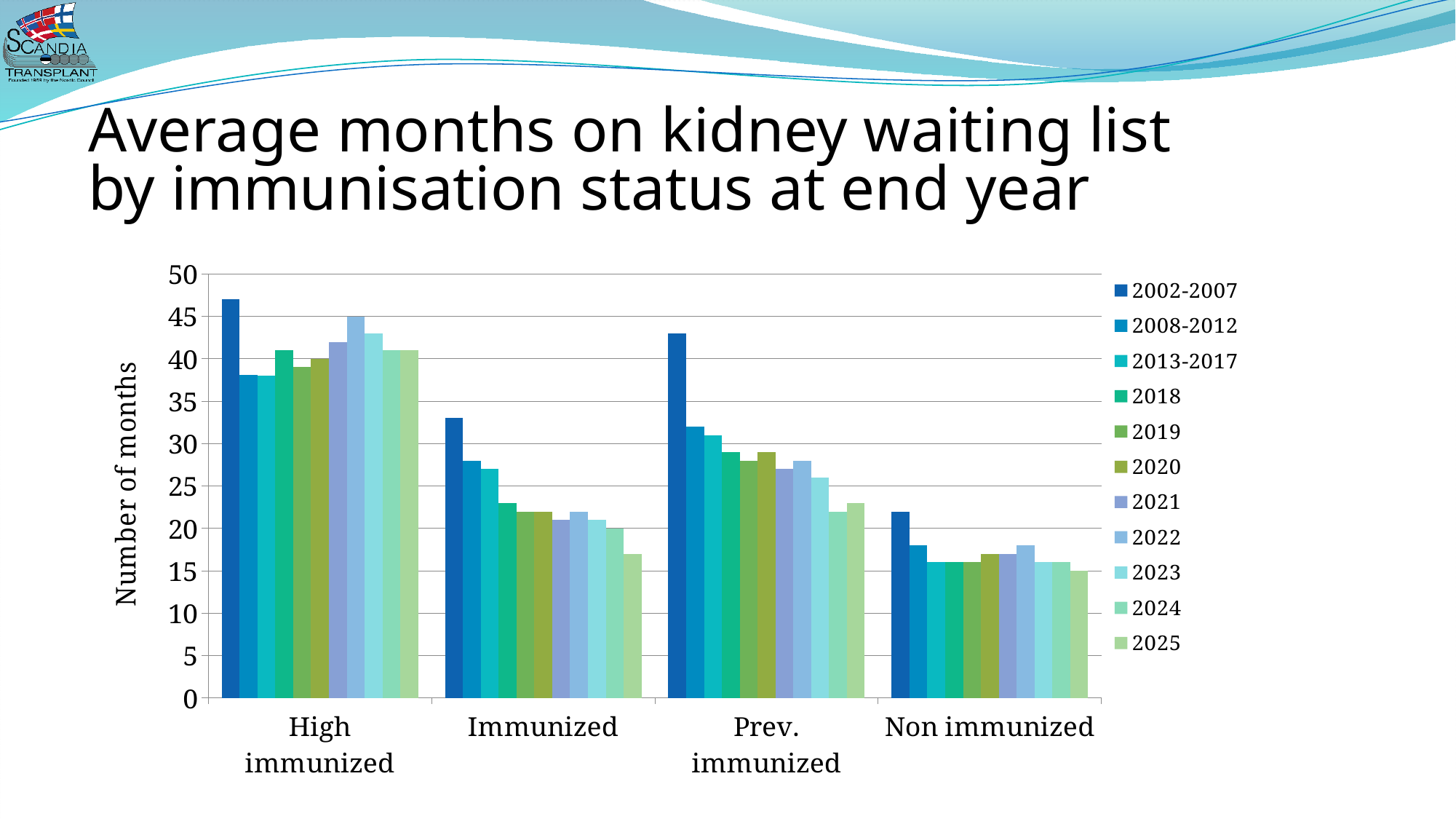
Is the 2025 value for Immunized greater or less than 20? less Which category has the lowest value for the 2002-2007 series? Non immunized How many series does the legend list? 11 How many immunisation status categories are shown on the x axis? 4 Within the Immunized group, which series has the lowest value? 2025 Is the 2002-2007 value for High immunized greater or less than 45? greater Within the Non immunized group, which series has the highest value? 2002-2007 What kind of chart is shown on the slide? bar chart Which category has the highest value for the 2002-2007 series? High immunized Is the 2002-2007 value for Prev. immunized greater or less than 40? greater For the 2002-2007 series, which is larger: Immunized or Prev. immunized? Prev. immunized What is the label on the vertical axis? Number of months